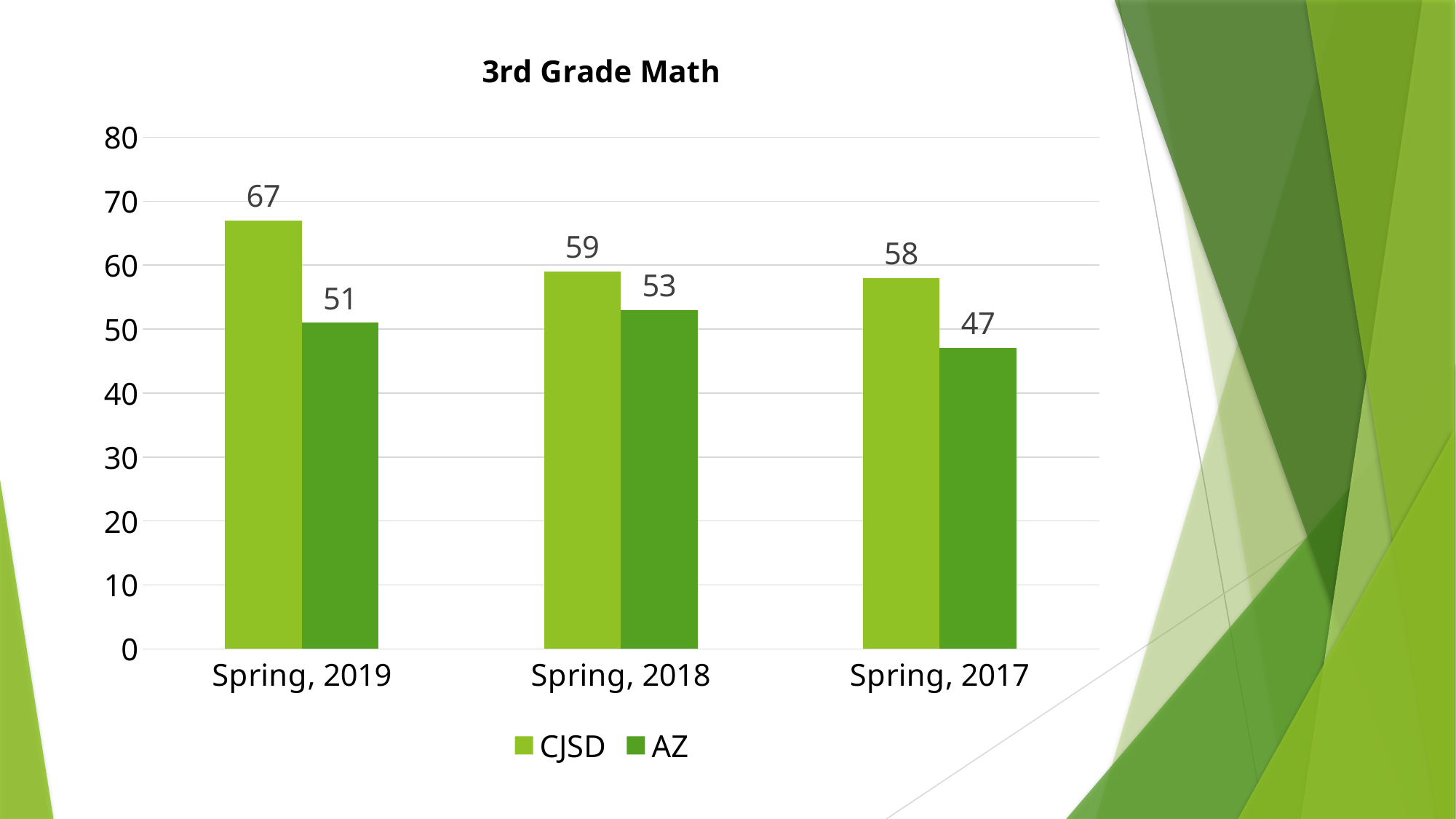
How many series does the legend list? 2 What is the difference between the CJSD values for Spring, 2018 and Spring, 2017? 1 Which is larger for Spring, 2018: the CJSD value or the AZ value? CJSD What is the CJSD value for Spring, 2019? 67 What kind of chart is shown on the slide? bar chart What is the AZ value for Spring, 2017? 47 How many periods are shown on the x axis? 3 What is the difference between the CJSD and AZ values for Spring, 2019? 16 Which period has the lowest AZ value? Spring, 2017 What is the AZ value for Spring, 2018? 53 Which period has the highest CJSD value? Spring, 2019 Is the AZ value for Spring, 2019 greater or less than 60? less